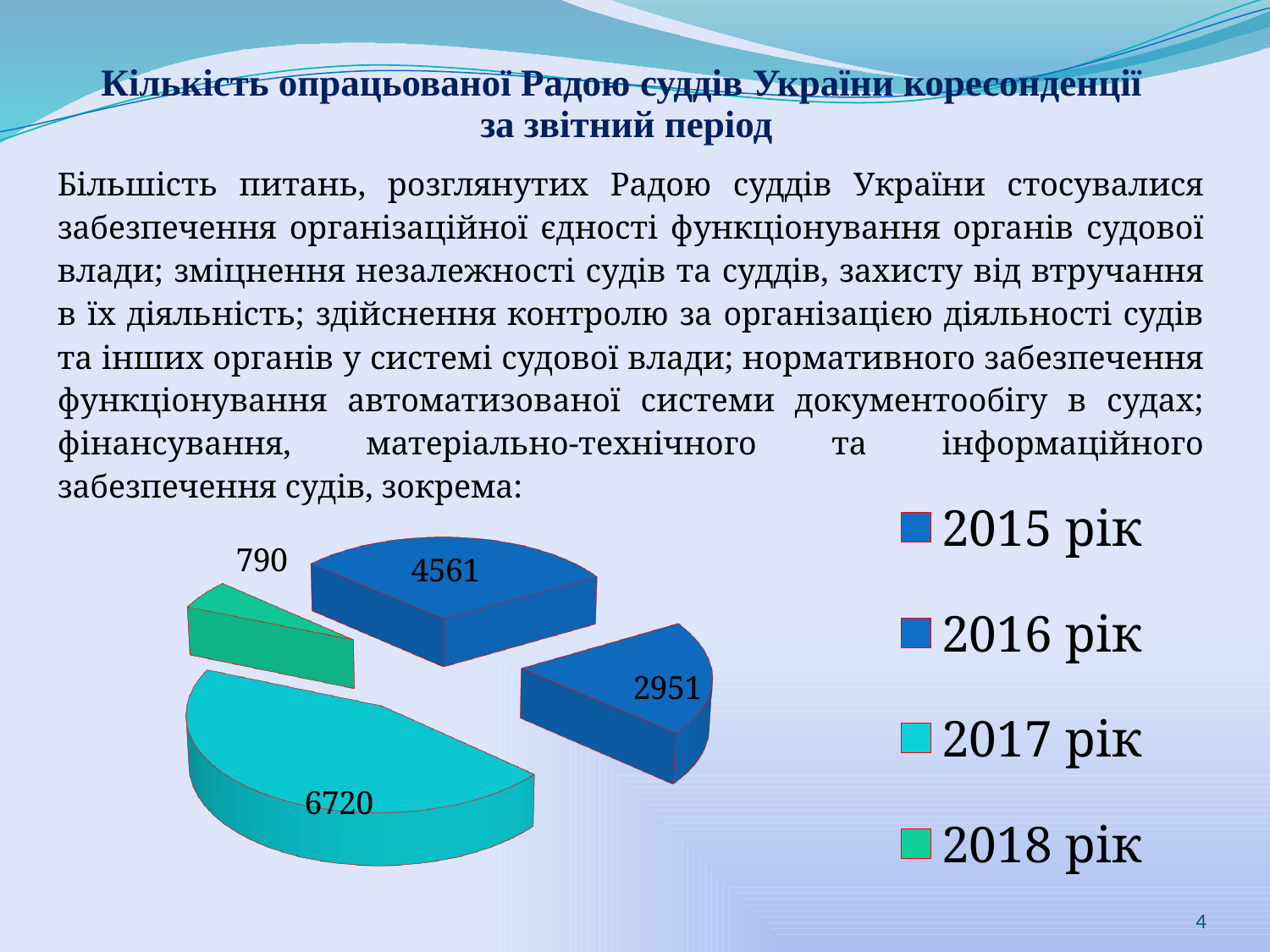
Which is larger, the value for 2015 рік or the value for 2016 рік? 2015 рік What is the value shown for 2017 рік in the pie chart? 6720 How many entries does the legend of the pie chart list? 4 What is the value shown for 2015 рік in the pie chart? 4561 What is the value shown for 2016 рік in the pie chart? 2951 What is the value shown for 2018 рік in the pie chart? 790 Which year has the smallest slice in the pie chart? 2018 рік What is the total of all four values in the pie chart? 15022 What kind of chart is shown on the slide? pie chart Which year has the largest slice in the pie chart? 2017 рік What is the difference between the values for 2017 рік and 2015 рік? 2159 How many slices does the pie chart have? 4